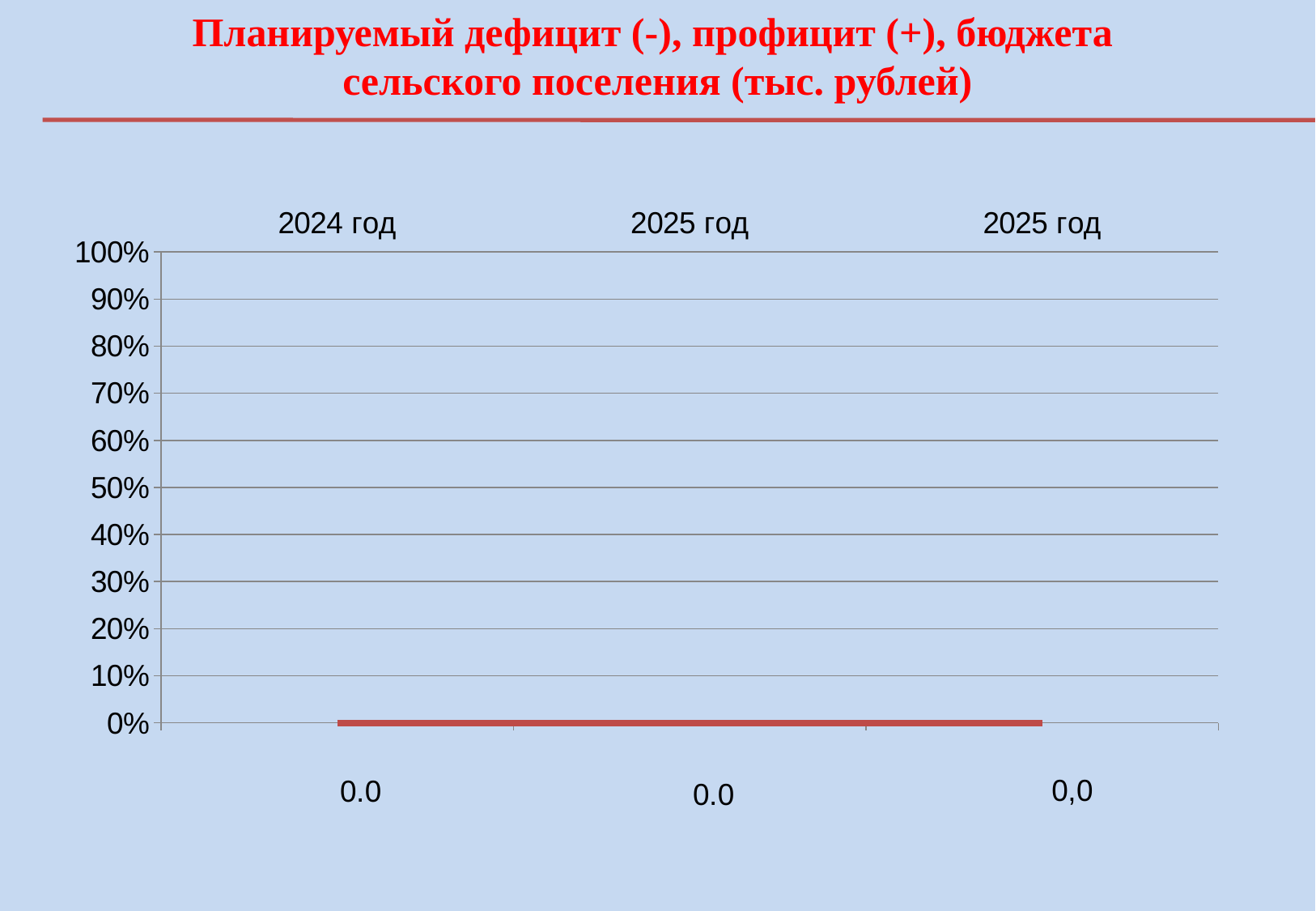
What kind of chart is shown on the slide? line chart What value is shown for 2024 год? 0.0 What is the label of the leftmost category on the x axis? 2024 год Do the plotted values rise, fall, or stay flat from left to right along the x axis? stay flat Is the value for 2024 год greater or less than 10%? less What value is shown for the middle category (2025 год)? 0.0 What value is shown for the rightmost category on the chart? 0,0 How many categories (years) are shown along the x axis of the chart? 3 What is the title of the slide? Планируемый дефицит (-), профицит (+), бюджета сельского поселения (тыс. рублей) What is the highest value shown on the y axis of the chart? 100%